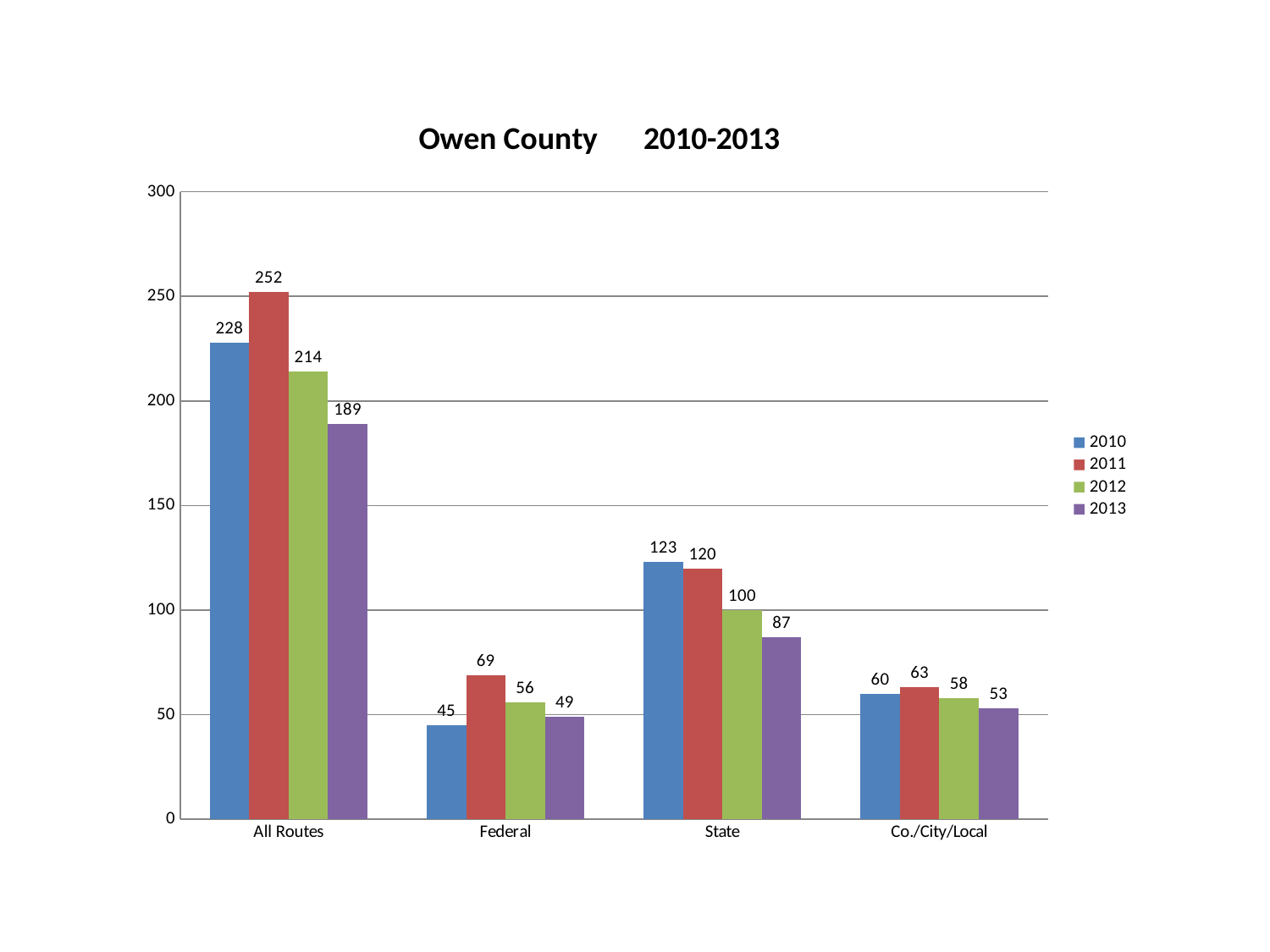
Which year has the highest value for All Routes? 2011 Which is larger, the 2012 value for Federal or the 2012 value for Co./City/Local? Co./City/Local What is the value for Federal in 2010? 45 What is the value for All Routes in 2011? 252 How many categories are shown on the x axis? 4 Which category has the lowest value in 2013? Federal What is the title of the chart? Owen County 2010-2013 What is the difference between the 2010 and 2013 values for All Routes? 39 How many series does the legend list? 4 What is the value for State in 2013? 87 Is the value for State in 2012 greater or less than 50? greater What kind of chart is shown on the slide? bar chart